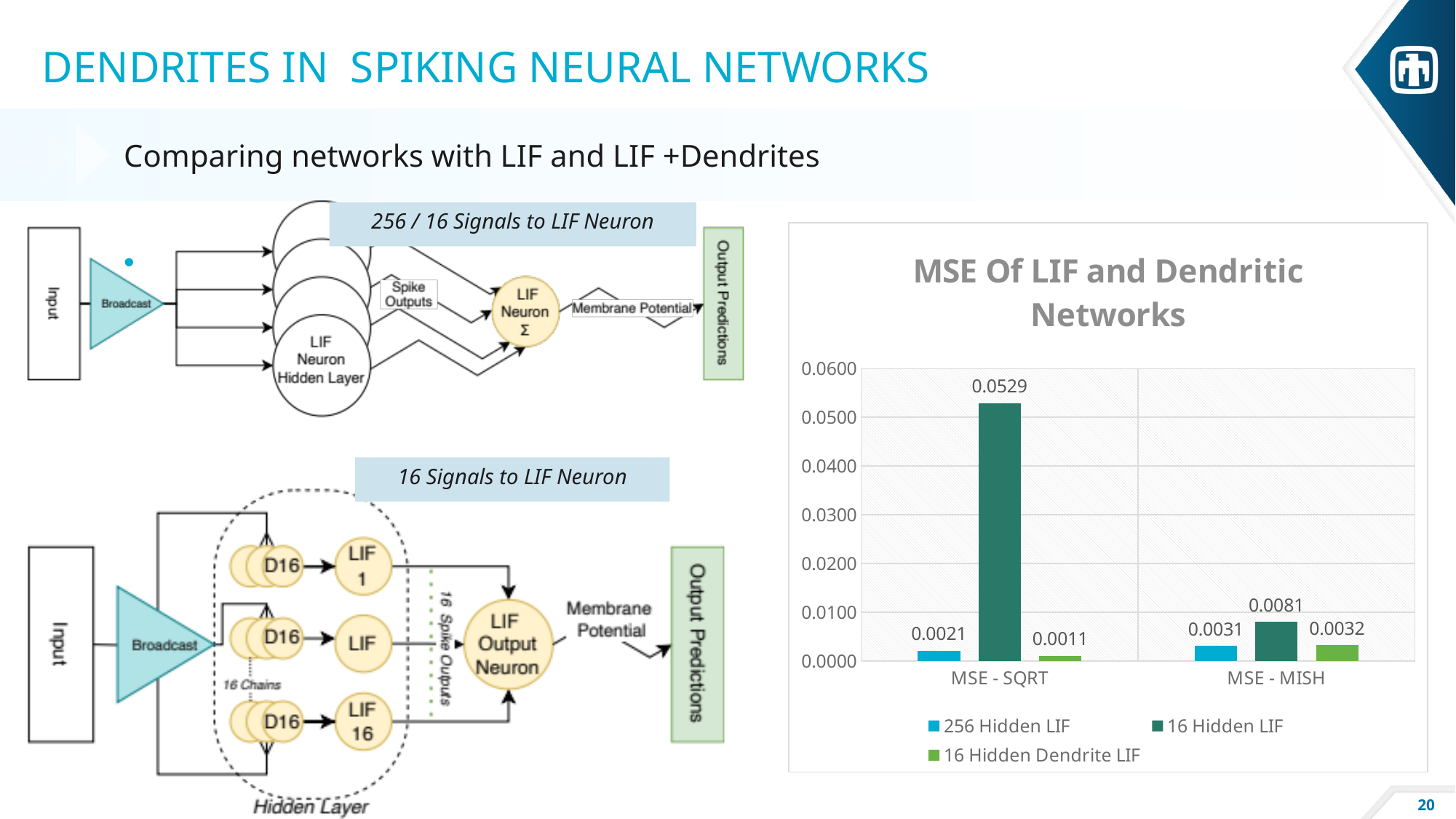
What is the difference between the 16 Hidden LIF and 16 Hidden Dendrite LIF values in the MSE - MISH category? 0.0049 What is the MSE for 16 Hidden Dendrite LIF in the MSE - MISH category? 0.0032 What is the difference between the 16 Hidden LIF and 256 Hidden LIF values in the MSE - SQRT category? 0.0508 Is the 16 Hidden LIF value for MSE - SQRT greater or less than 0.0500? greater How many series does the legend list? 3 What is the MSE for 256 Hidden LIF in the MSE - MISH category? 0.0031 What is the MSE for 16 Hidden LIF in the MSE - SQRT category? 0.0529 What is the MSE for 16 Hidden Dendrite LIF in the MSE - SQRT category? 0.0011 Which is larger: the 16 Hidden LIF value for MSE - SQRT or for MSE - MISH? MSE - SQRT Which series has the lowest value in the MSE - SQRT category? 16 Hidden Dendrite LIF Which series has the highest value in the MSE - SQRT category? 16 Hidden LIF What kind of chart is shown on the slide? Bar chart